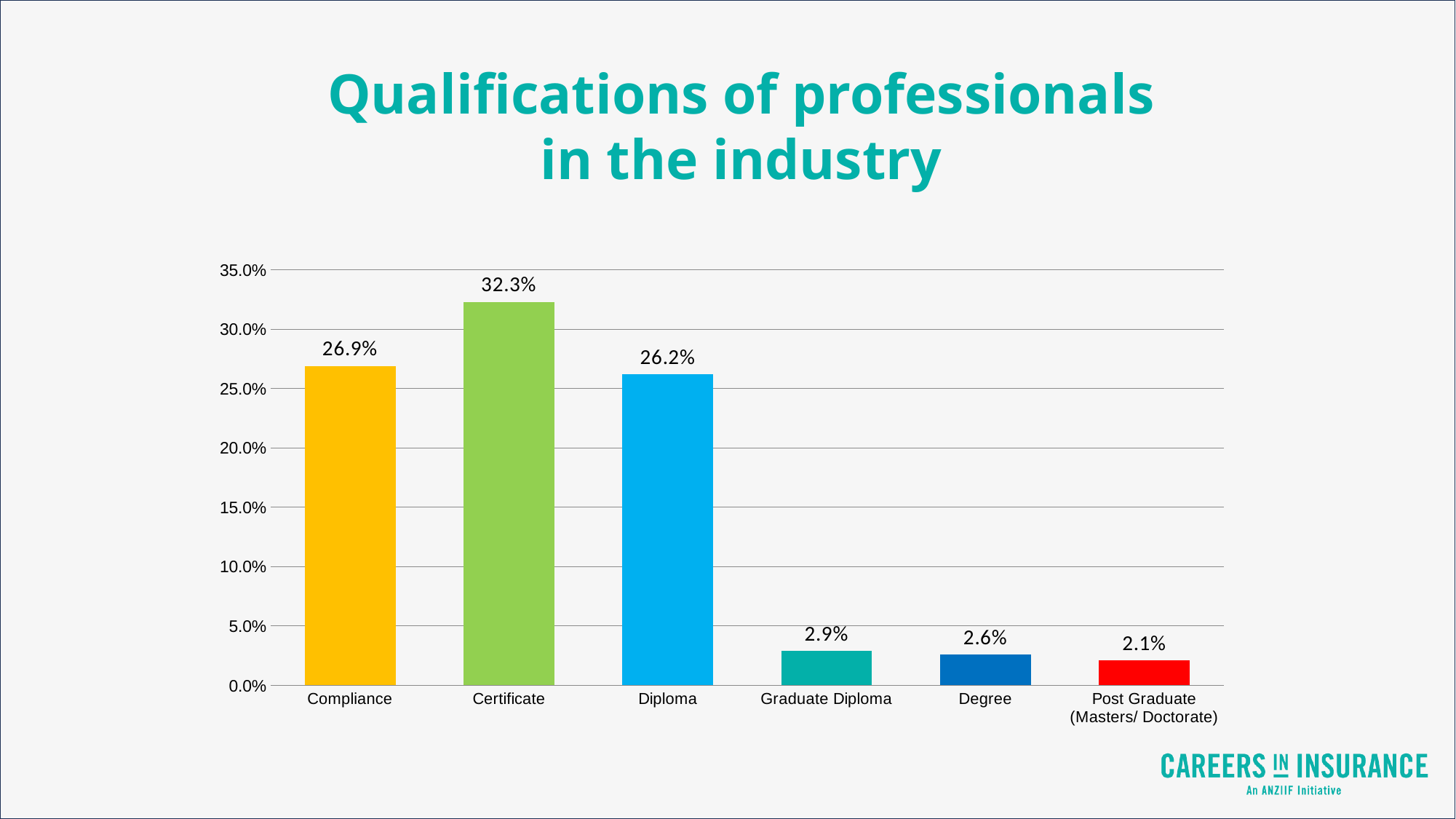
What is the difference between the values for Certificate and Diploma? 6.1% What is the value for Compliance? 26.9% Which is larger, the value for Compliance or the value for Diploma? Compliance What is the value for Certificate? 32.3% What is the value for Post Graduate (Masters/ Doctorate)? 2.1% What kind of chart is shown on the slide? Bar chart What is the value for Graduate Diploma? 2.9% Which qualification has the highest value? Certificate Which qualification has the lowest value? Post Graduate (Masters/ Doctorate) How many qualification categories are shown on the chart? 6 Is the value for Diploma greater or less than 25.0%? greater What is the difference between the values for Compliance and Degree? 24.3%